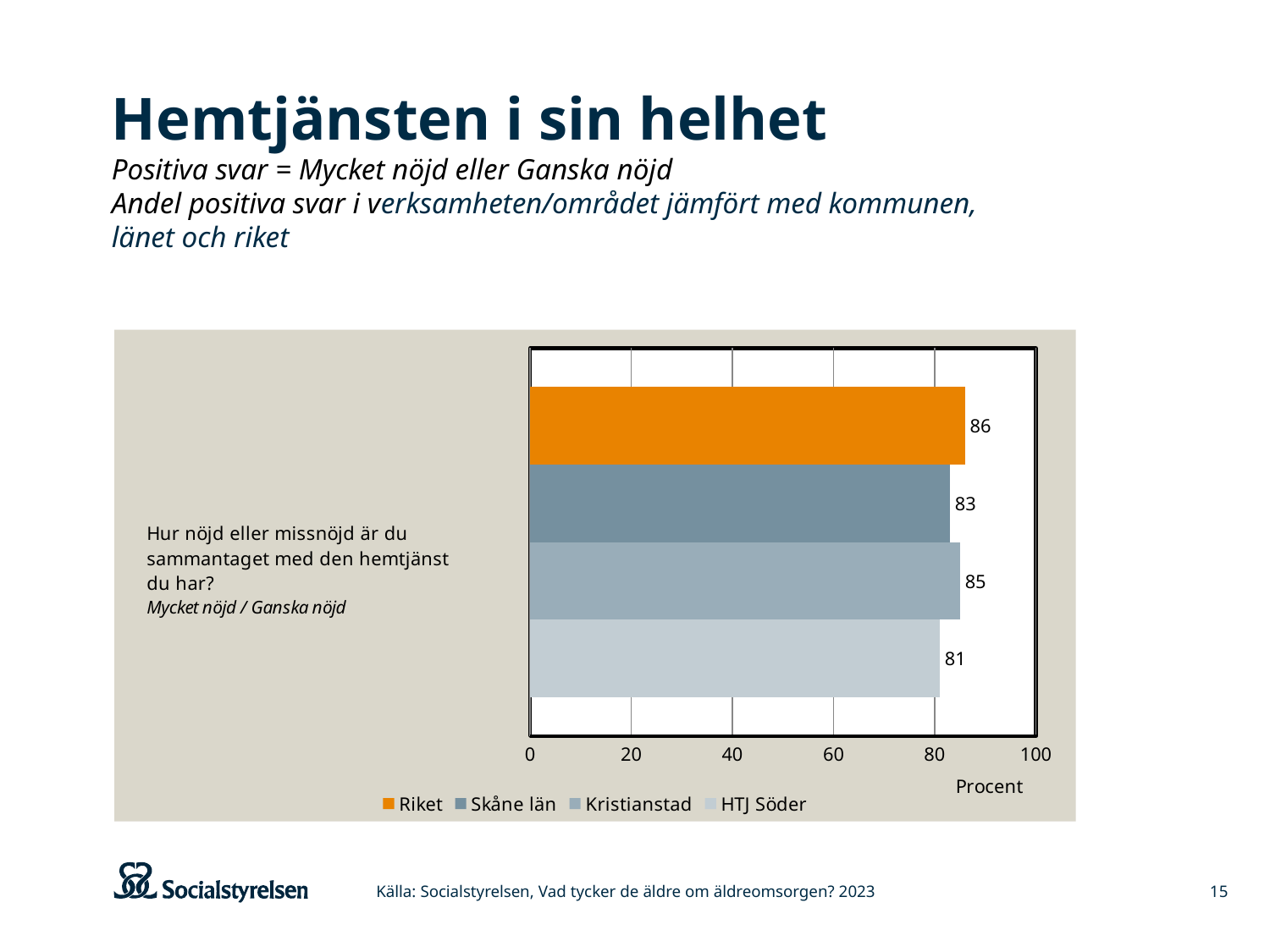
Which series has the highest value? Riket How many series does the legend list? 4 What is the difference between the values for Kristianstad and Skåne län? 2 What is the label of the horizontal axis? Procent Which series has the lowest value? HTJ Söder What is the difference between the values for Riket and HTJ Söder? 5 What is the value for Riket? 86 What is the value for Skåne län? 83 What kind of chart is shown on the slide? Bar chart Which is larger, the value for Kristianstad or the value for HTJ Söder? Kristianstad What is the value for Kristianstad? 85 What is the value for HTJ Söder? 81